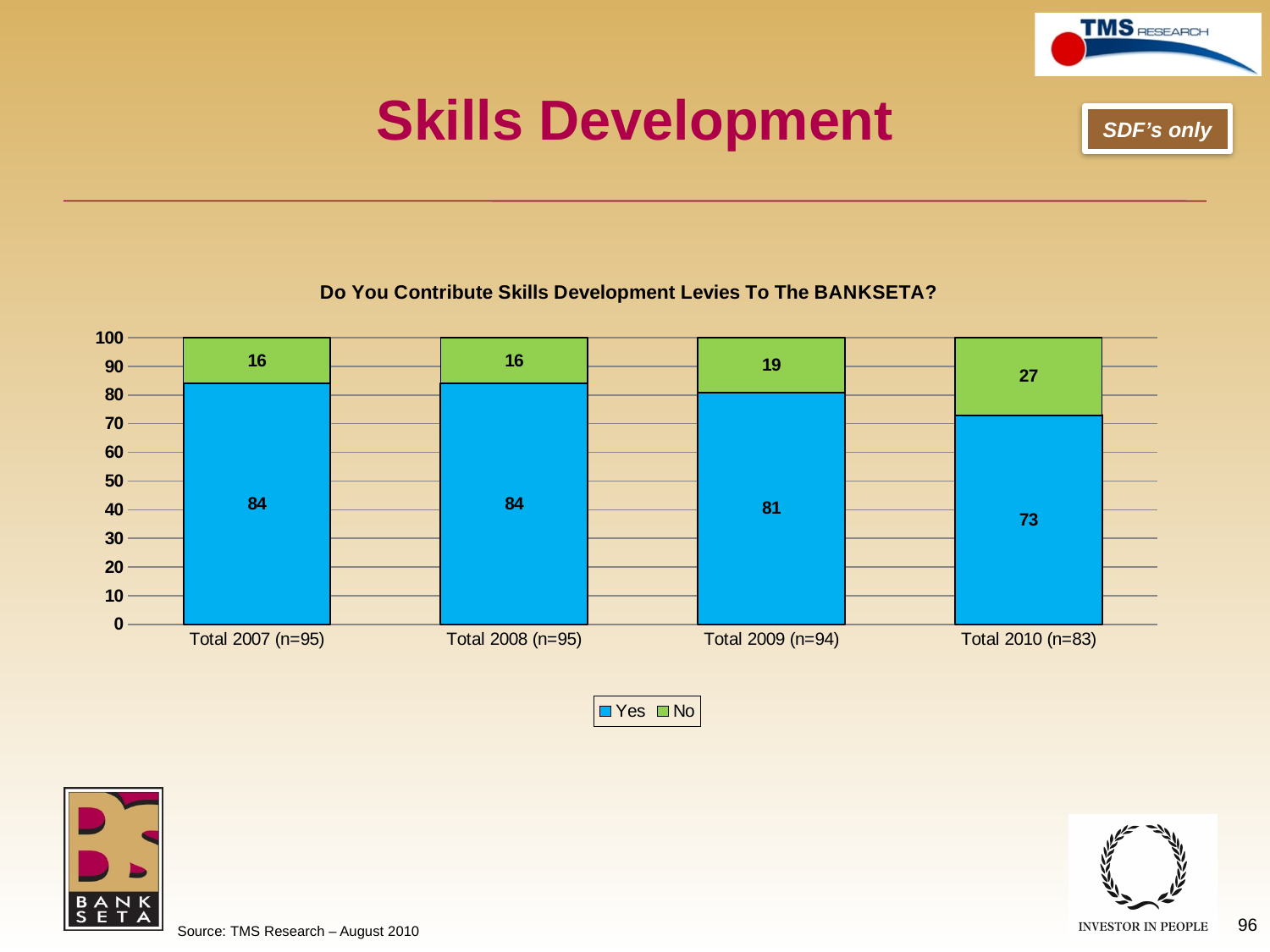
Which is larger: the 'No' value for Total 2009 (n=94) or the 'No' value for Total 2008 (n=95)? Total 2009 (n=94) Which category has the highest 'No' value? Total 2010 (n=83) Does the 'Yes' value rise or fall from Total 2008 (n=95) to Total 2010 (n=83)? Fall What is the total of the stacked bar for Total 2010 (n=83)? 100 What kind of chart is shown? Stacked bar chart Which category has the lowest 'Yes' value? Total 2010 (n=83) What is the 'Yes' value for Total 2010 (n=83)? 73 What is the 'No' value for Total 2009 (n=94)? 19 What is the difference between the 'Yes' values for Total 2007 (n=95) and Total 2010 (n=83)? 11 How many categories are shown on the x axis? 4 How many series does the legend list? 2 What is the 'Yes' value for Total 2007 (n=95)? 84